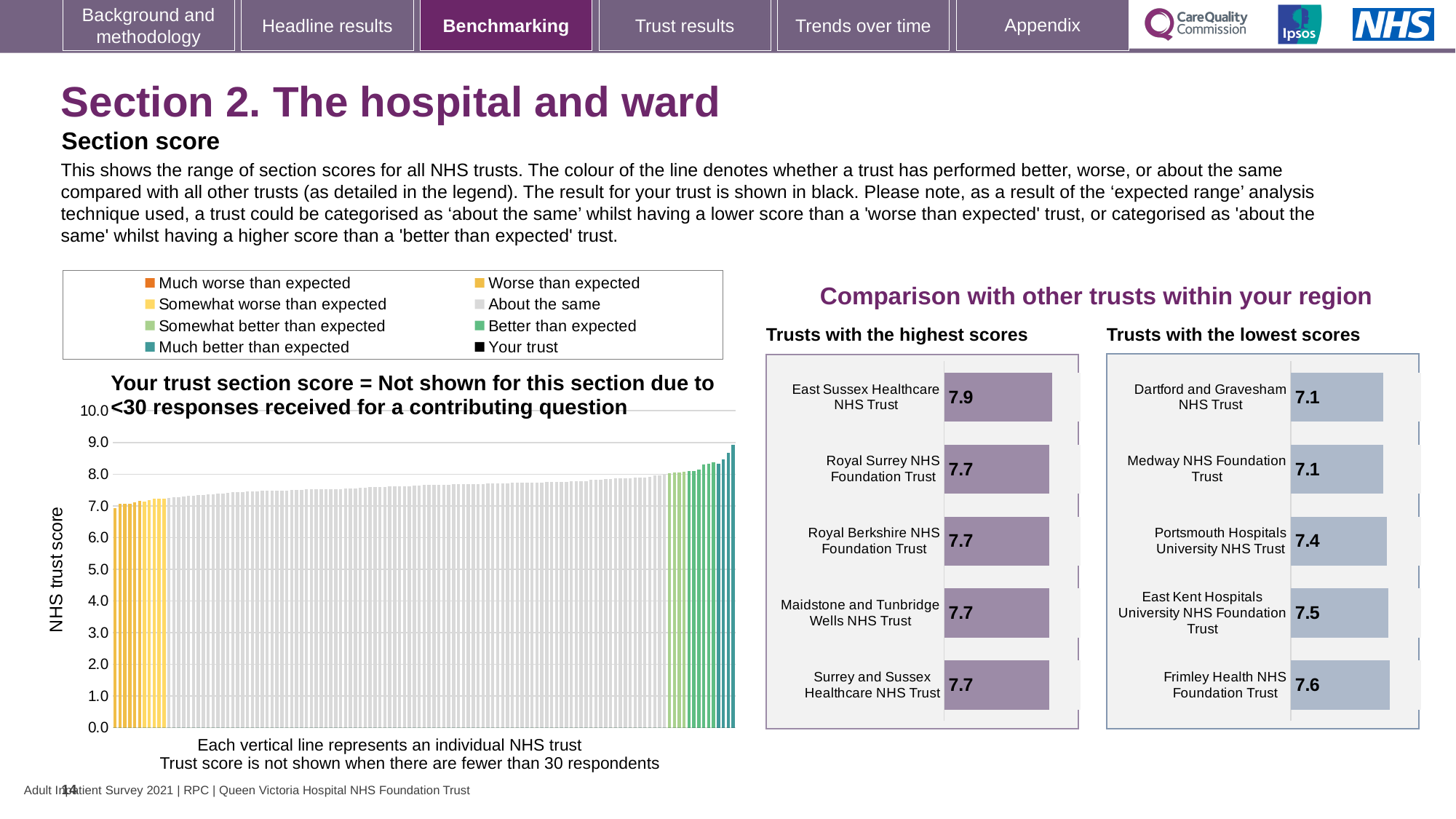
In the 'Trusts with the lowest scores' chart, what is the score for Frimley Health NHS Foundation Trust? 7.6 In the 'Trusts with the lowest scores' chart, what is the score for Portsmouth Hospitals University NHS Trust? 7.4 What kind of chart is the large chart on the left showing the range of section scores for all NHS trusts? Bar chart In the 'Trusts with the lowest scores' chart, which trust has the highest score shown? Frimley Health NHS Foundation Trust In the large chart on the left showing all NHS trusts, do the scores rise or fall from left to right? Rise In the large chart on the left showing all NHS trusts, is the value of the tallest bar on the far right greater or less than 8.0? greater In the 'Trusts with the highest scores' chart, which trust has the highest score? East Sussex Healthcare NHS Trust How many trusts are listed in the 'Trusts with the highest scores' chart? 5 In the 'Trusts with the highest scores' chart, what is the score for East Sussex Healthcare NHS Trust? 7.9 In the 'Trusts with the highest scores' chart, what is the difference between the scores of East Sussex Healthcare NHS Trust and Royal Surrey NHS Foundation Trust? 0.2 In the 'Trusts with the lowest scores' chart, what is the difference between the scores of Frimley Health NHS Foundation Trust and Dartford and Gravesham NHS Trust? 0.5 In the 'Trusts with the lowest scores' chart, which has the larger score: Portsmouth Hospitals University NHS Trust or East Kent Hospitals University NHS Foundation Trust? East Kent Hospitals University NHS Foundation Trust